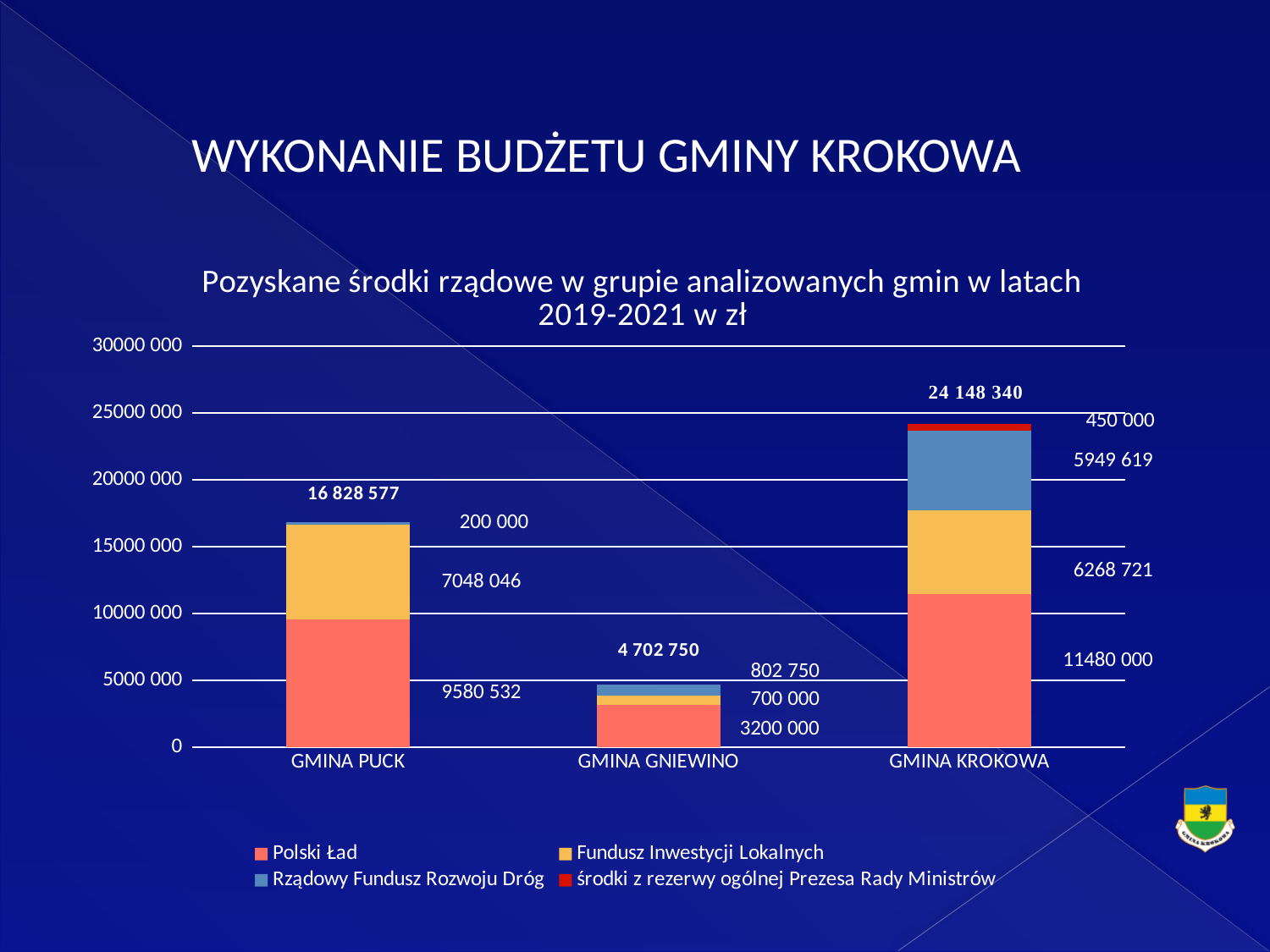
What type of chart is shown on the slide? stacked bar chart What is the Fundusz Inwestycji Lokalnych value for Gmina Puck? 7048 046 What is the difference between the total for Gmina Krokowa (24 148 340) and the total for Gmina Puck (16 828 577)? 7 319 763 Which municipality has the lowest total of acquired government funds? Gmina Gniewino What is the total value labelled above the bar for Gmina Krokowa? 24 148 340 What is the total value labelled above the bar for Gmina Puck? 16 828 577 Is the total for Gmina Gniewino greater or less than 5000 000? less How many series does the legend list? 4 What is the Polski Ład value for Gmina Krokowa? 11480 000 How many municipalities (categories) are shown on the x axis? 3 What is the total value labelled above the bar for Gmina Gniewino? 4 702 750 Which municipality has the highest total of acquired government funds? Gmina Krokowa